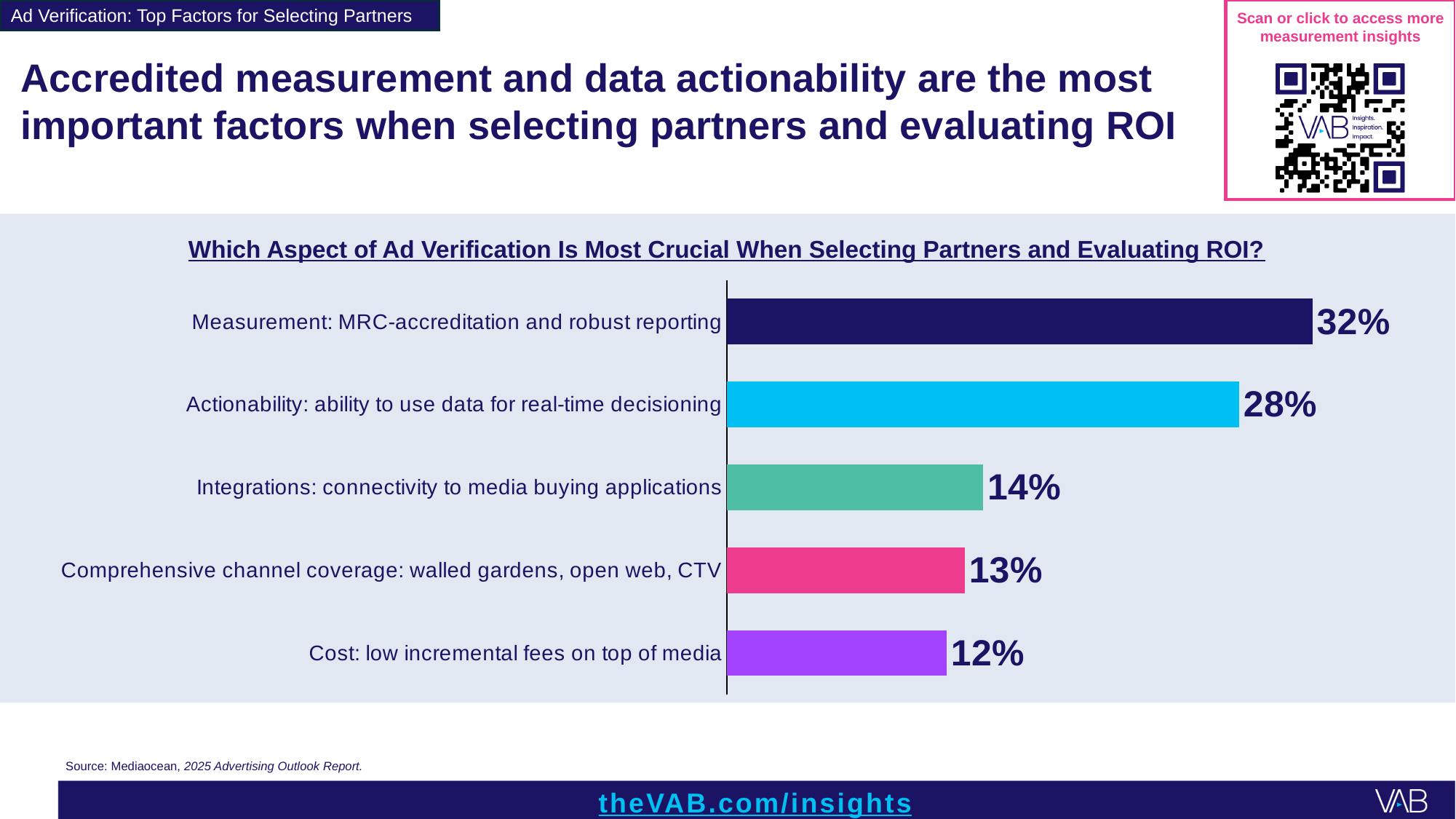
What is the difference in percentage points between Measurement and Actionability? 4 percentage points How many aspects of ad verification are shown in the chart? 5 What is the title of the chart? Which Aspect of Ad Verification Is Most Crucial When Selecting Partners and Evaluating ROI? Which aspect of ad verification has the lowest percentage? Cost: low incremental fees on top of media Which has a larger percentage: Actionability or Comprehensive channel coverage? Actionability What percentage is shown for Integrations: connectivity to media buying applications? 14% What is the difference in percentage points between Integrations and Cost? 2 percentage points What percentage is shown for Measurement: MRC-accreditation and robust reporting? 32% Which aspect of ad verification has the highest percentage? Measurement: MRC-accreditation and robust reporting What percentage is shown for Actionability: ability to use data for real-time decisioning? 28% What percentage is shown for Cost: low incremental fees on top of media? 12% What type of chart is used on this slide? Bar chart